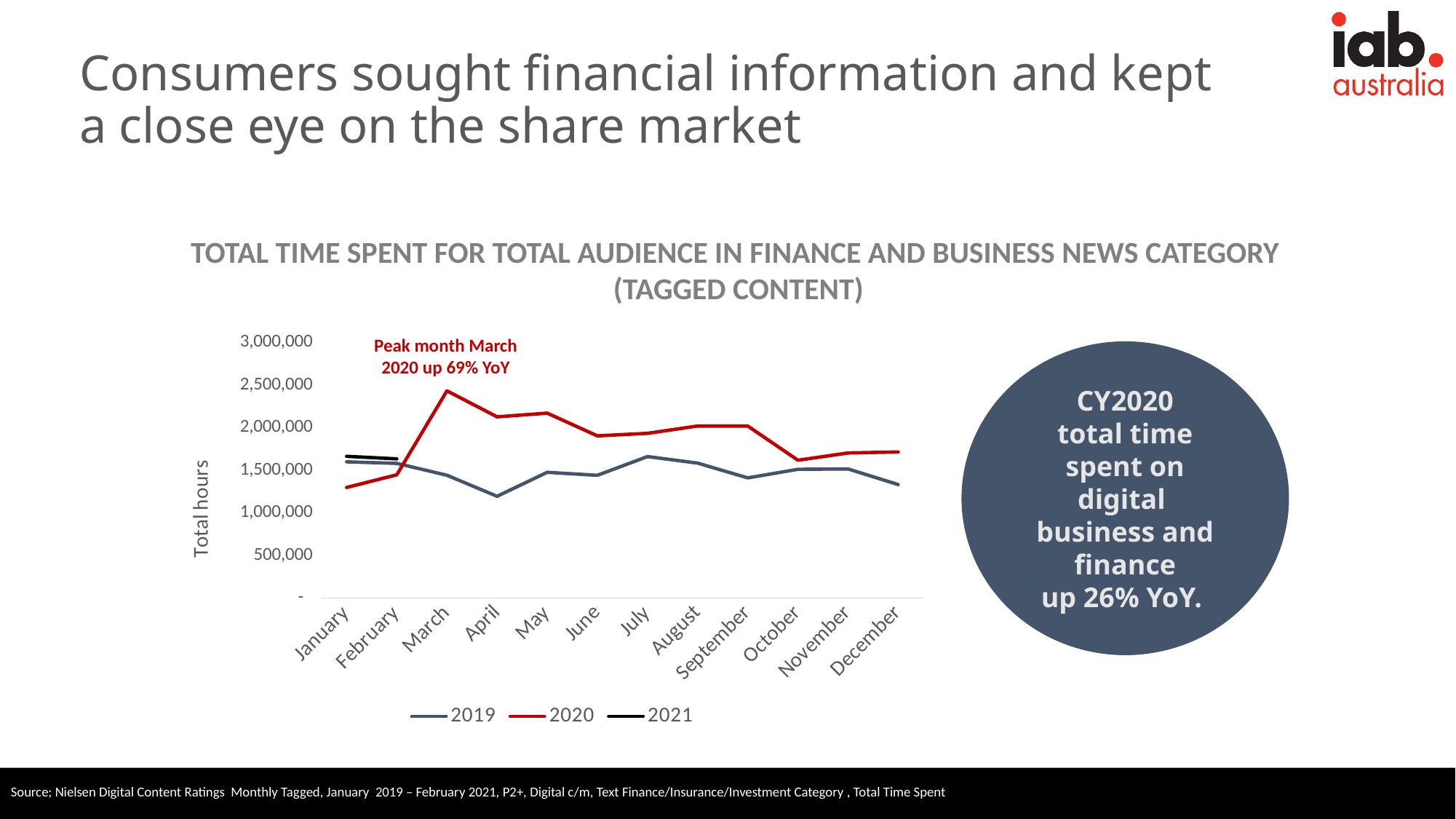
How many months are shown along the x axis of the chart? 12 How many series does the chart legend list? 3 Which series has the larger value in March, 2019 or 2020? 2020 In which month does the 2020 series have its lowest value? January In which month does the 2020 series reach its highest value? March Is the value for 2019 in April greater or less than 1,500,000? less According to the annotation on the chart, by what percentage was the peak month of March 2020 up year on year? 69% Which series has the larger value in January, 2019 or 2020? 2019 Is the value for 2020 in March greater or less than 2,000,000? greater In which month does the 2019 series reach its lowest value? April What kind of chart is shown on the slide? Line chart Is the value for 2020 in August greater or less than 1,500,000? greater